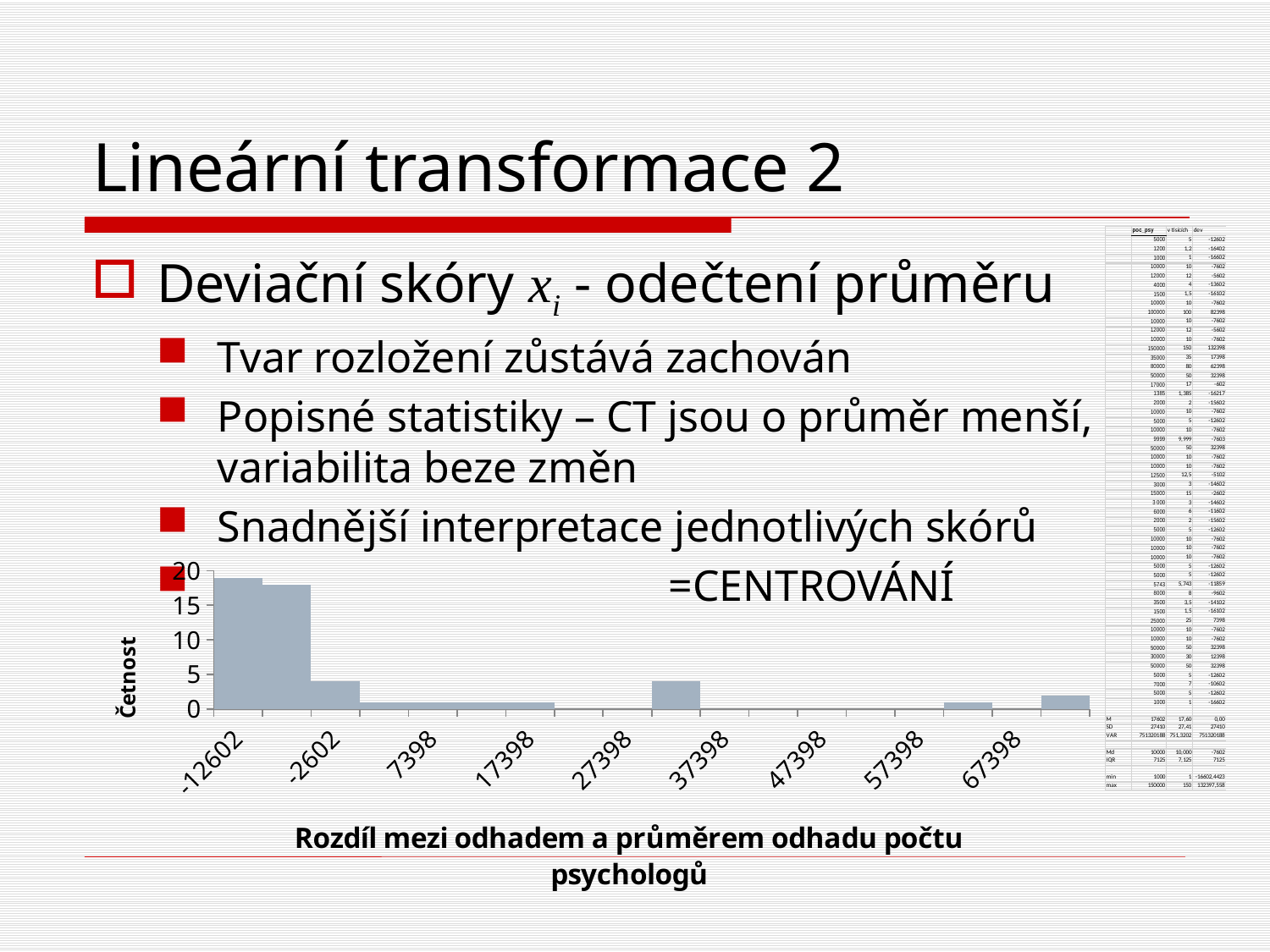
Which bar is taller, the one at -2602 or the one at 67398? -2602 What kind of chart is shown on the slide? bar chart Is the value of the bar at 67398 greater or less than 5? less What is the highest value shown on the vertical axis of the chart? 20 Which bar is taller, the one at -12602 or the one at 37398? -12602 Is the value of the bar at 37398 greater or less than 10? less What is the label of the vertical axis of the chart? Četnost Is the value of the bar at -2602 greater or less than 15? less How many tick labels are printed along the horizontal axis of the chart? 9 What is the title printed below the horizontal axis of the chart? Rozdíl mezi odhadem a průměrem odhadu počtu psychologů